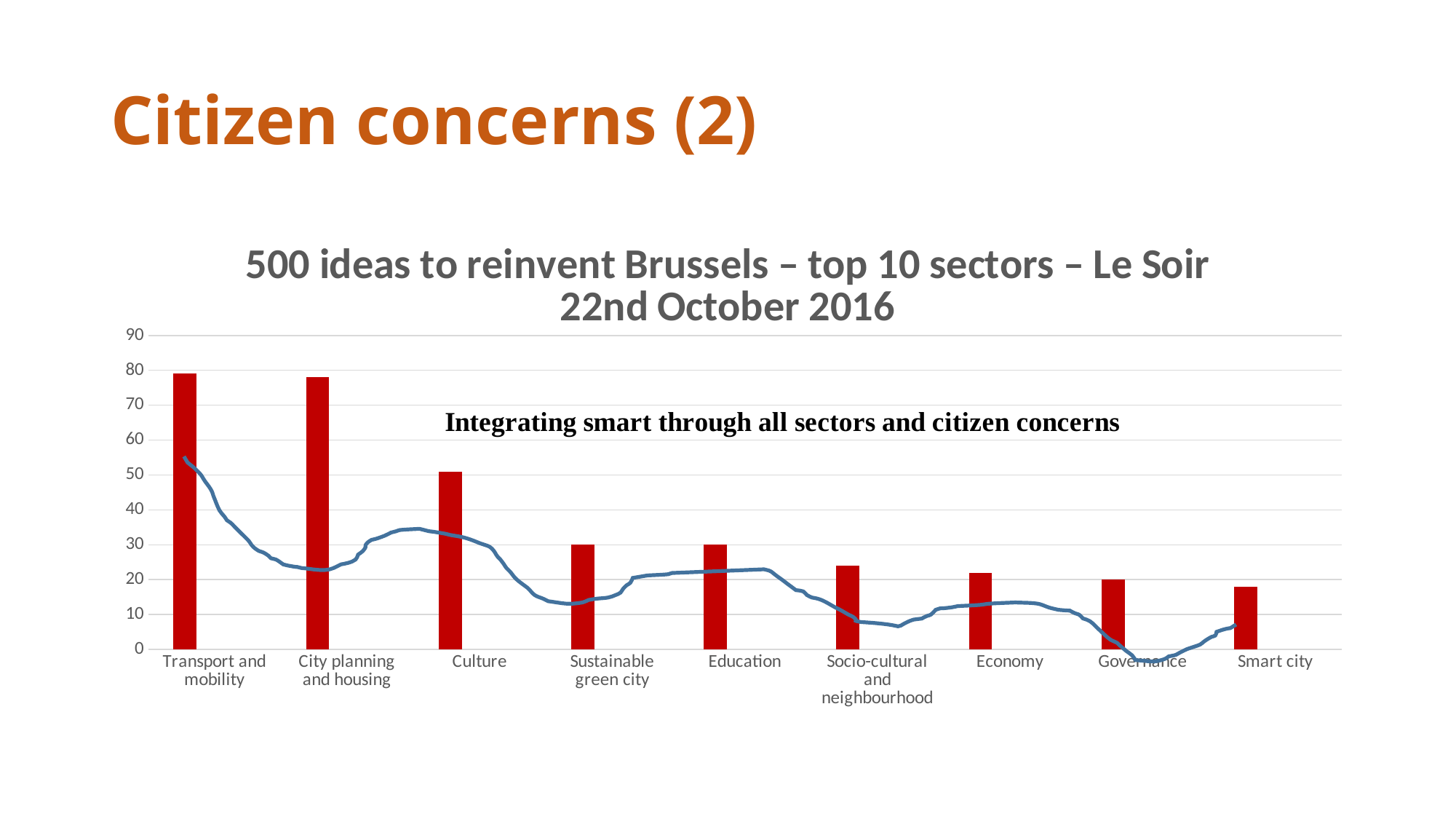
Which has the larger value, Culture or Education? Culture What colour are the bars in the chart? red Is the value for Culture greater or less than 40? greater What is the title of the chart? 500 ideas to reinvent Brussels – top 10 sectors – Le Soir 22nd October 2016 Which has the larger value, Transport and mobility or Culture? Transport and mobility How many sectors (categories) are shown on the x axis of the chart? 9 What kind of chart is shown on the slide? bar chart Is the value for Transport and mobility greater or less than 70? greater Is the value for Smart city greater or less than 30? less Do the bar values generally rise or fall from left to right along the x axis? fall